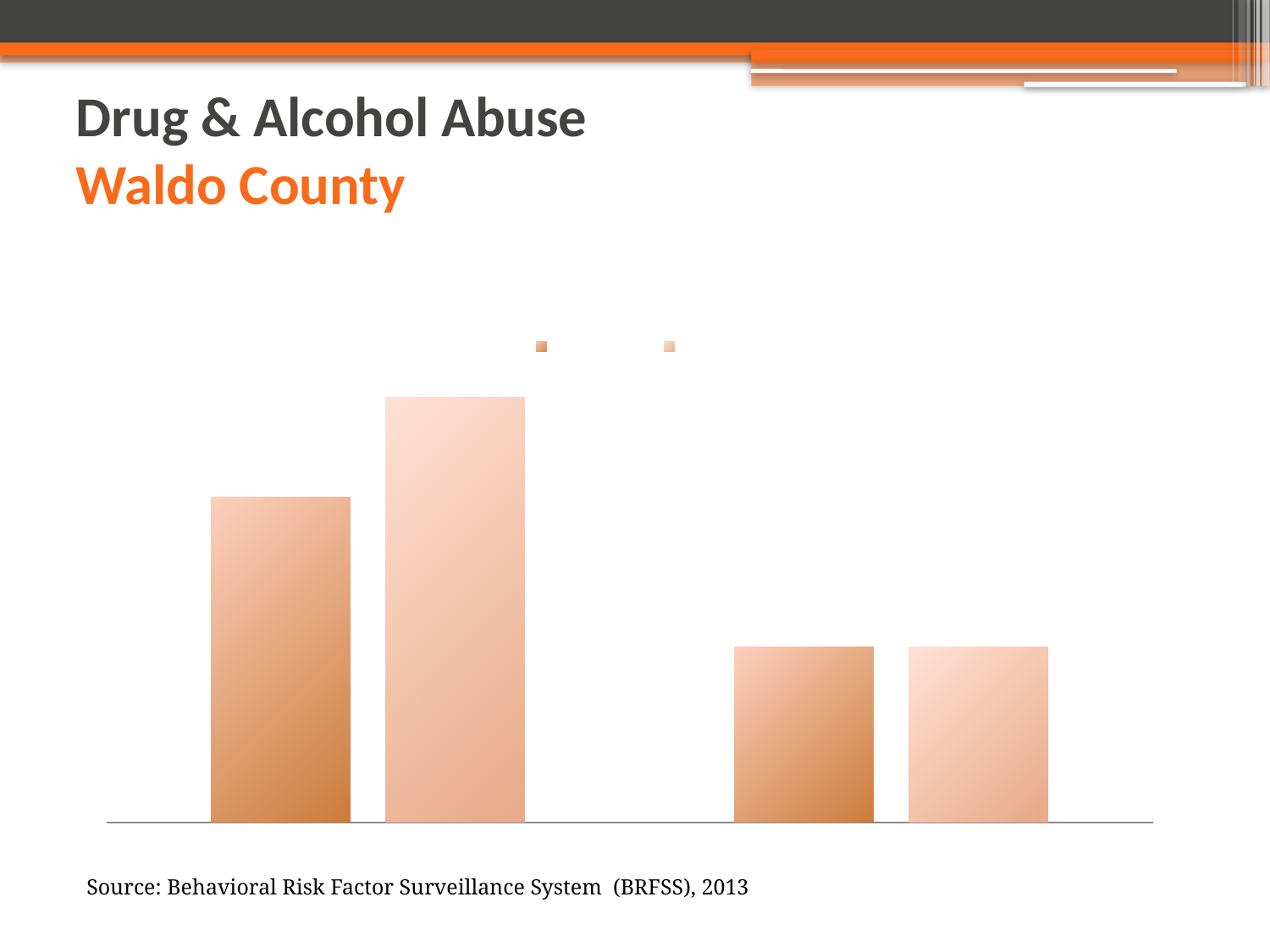
In the left group of bars, is the darker bar or the lighter bar taller? the lighter bar Which bar is the tallest in the chart, by position? the second bar from the left Which group of bars is taller, the left group or the right group? the left group What kind of chart is shown on the slide? bar chart How many groups of bars does the chart show? 2 What is the title of the slide containing the chart? Drug & Alcohol Abuse Waldo County How many series does the chart's legend list? 2 How many bars are plotted in the chart? 4 What source is cited below the chart? Behavioral Risk Factor Surveillance System (BRFSS), 2013